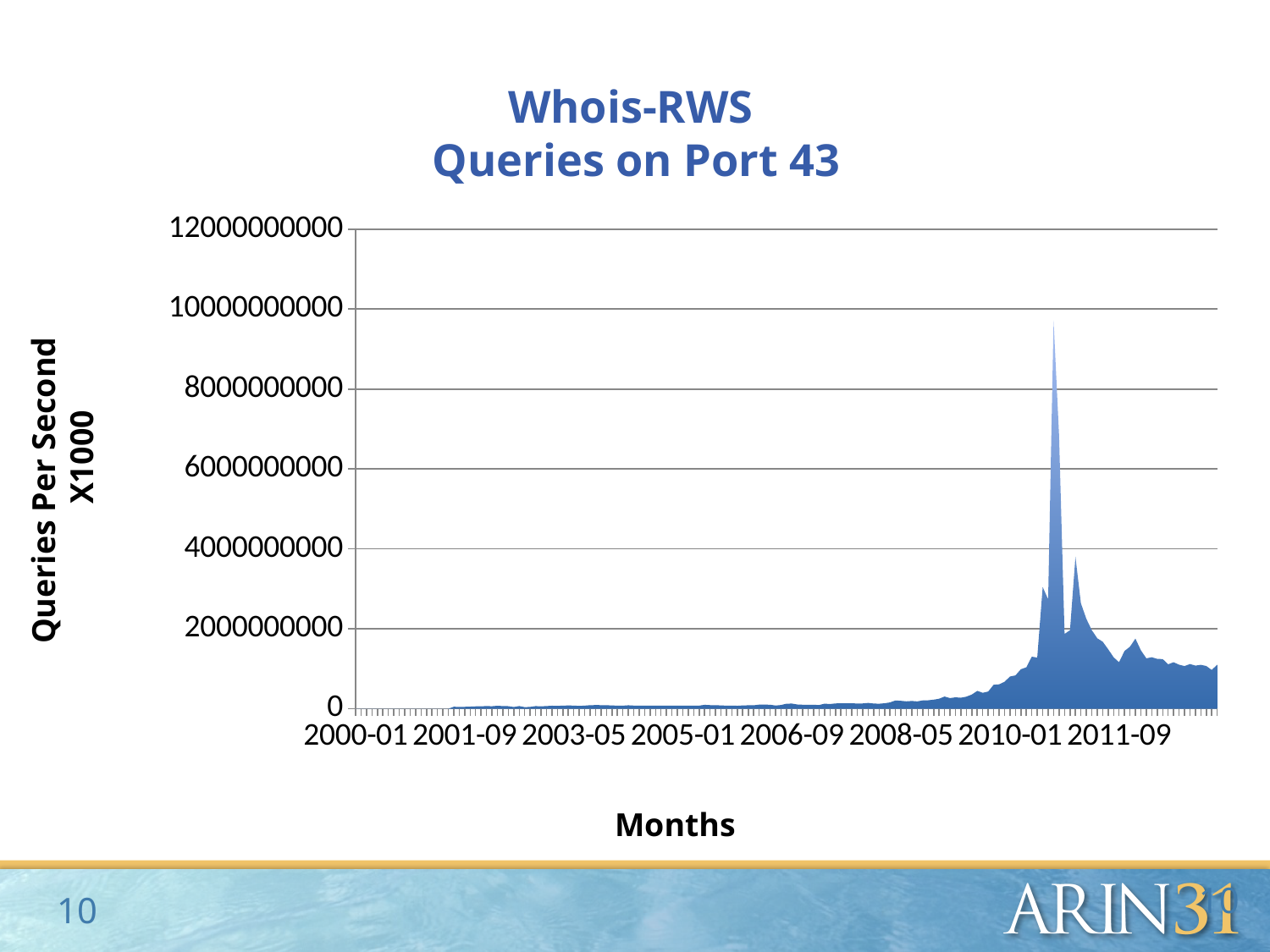
What is the label of the vertical axis? Queries Per Second X1000 What kind of chart is shown on the slide? Area chart How many date labels are shown on the x axis? 8 Is the value at 2008-05 greater or less than 2000000000? less Which is larger, the value at 2003-05 or the value at 2011-09? 2011-09 Do the values generally rise or fall from 2000-01 to the end of the series? rise Is the peak value of the chart greater or less than 10000000000? less What is the title of the chart? Whois-RWS Queries on Port 43 What is the highest value shown on the y axis? 12000000000 Is the value at 2011-09 greater or less than 4000000000? less